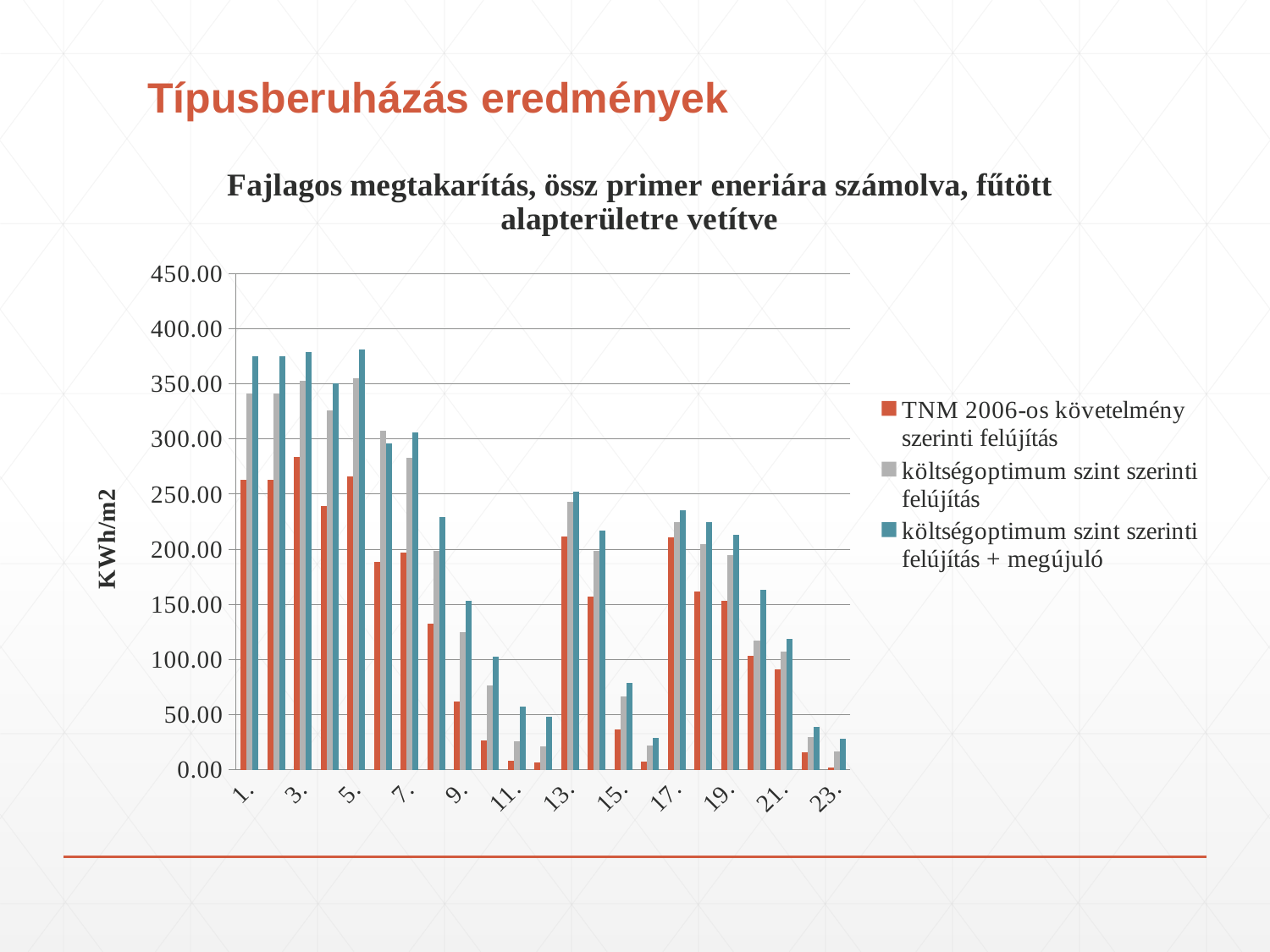
Is the value for category 1 in the 'TNM 2006-os követelmény szerinti felújítás' series greater or less than 250.00? greater Is the value for category 13 in the 'TNM 2006-os követelmény szerinti felújítás' series greater or less than 200.00? greater In the 'TNM 2006-os követelmény szerinti felújítás' series, which has the larger value: category 5 or category 9? category 5 Do the values of the 'TNM 2006-os követelmény szerinti felújítás' series generally rise or fall from category 5 to category 11? fall What is the label on the vertical axis? KWh/m2 Is the value for category 21 in the 'TNM 2006-os követelmény szerinti felújítás' series greater or less than 100.00? less How many series does the legend list? 3 Which legend entry is shown in orange? TNM 2006-os követelmény szerinti felújítás For category 1, which series has the larger value: 'TNM 2006-os követelmény szerinti felújítás' or 'költségoptimum szint szerinti felújítás + megújuló'? költségoptimum szint szerinti felújítás + megújuló What kind of chart is shown on the slide? bar chart How many categories are plotted along the x axis? 23